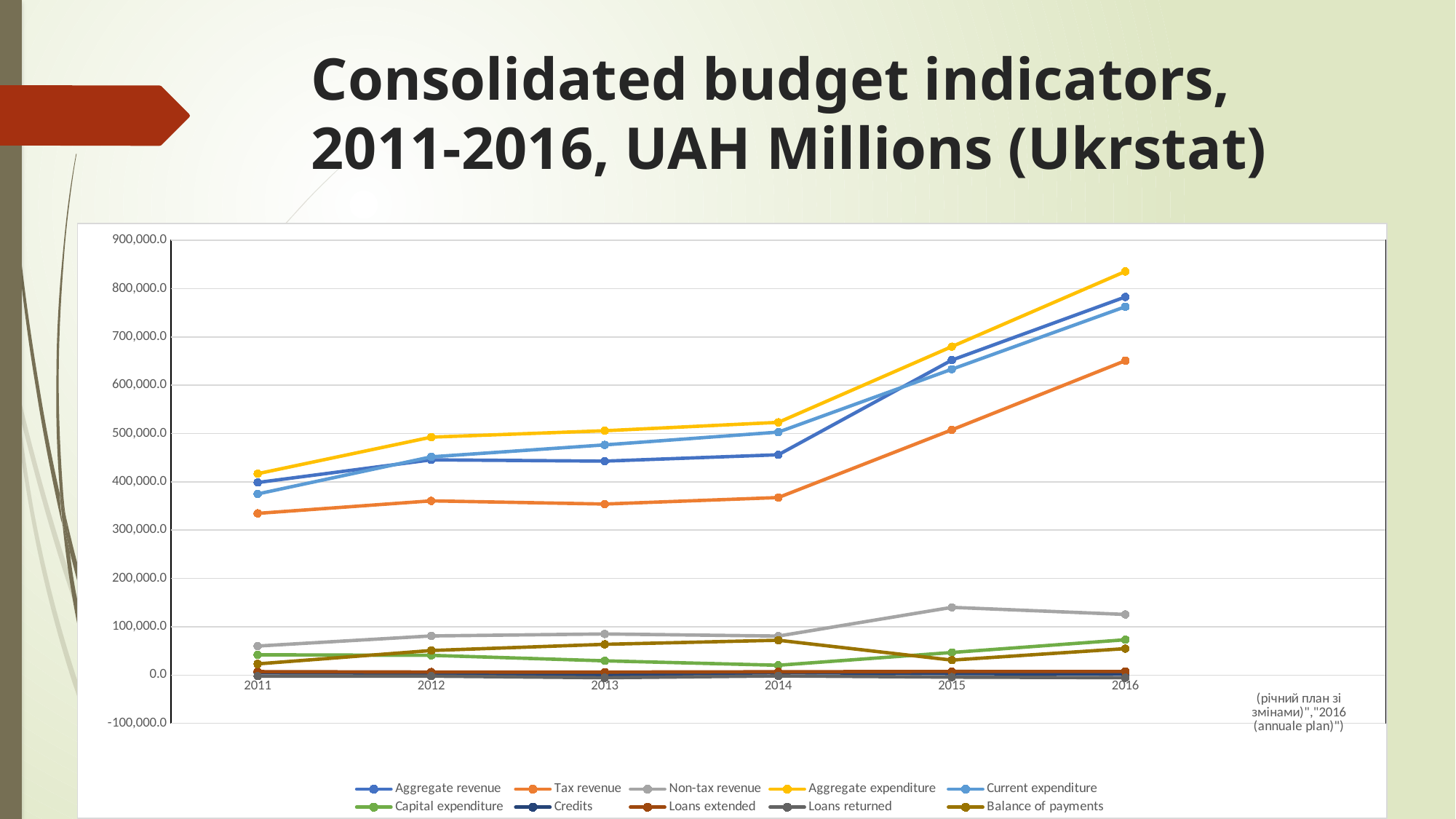
How many years are plotted along the x axis? 6 Does Aggregate expenditure rise or fall from 2011 to 2016? Rise Is the value for Non-tax revenue in 2015 greater or less than 100,000.0? greater What is the title of the slide? Consolidated budget indicators, 2011-2016, UAH Millions (Ukrstat) Which is larger in 2015, Aggregate expenditure or Tax revenue? Aggregate expenditure Is the value for Aggregate expenditure in 2016 greater or less than 800,000.0? greater Is the value for Tax revenue in 2011 greater or less than 400,000.0? less Which series has the highest value in 2016? Aggregate expenditure How many series does the legend list? 10 In which year is Aggregate expenditure at its highest? 2016 What kind of chart is shown on the slide? Line chart In which year is Tax revenue at its lowest? 2011